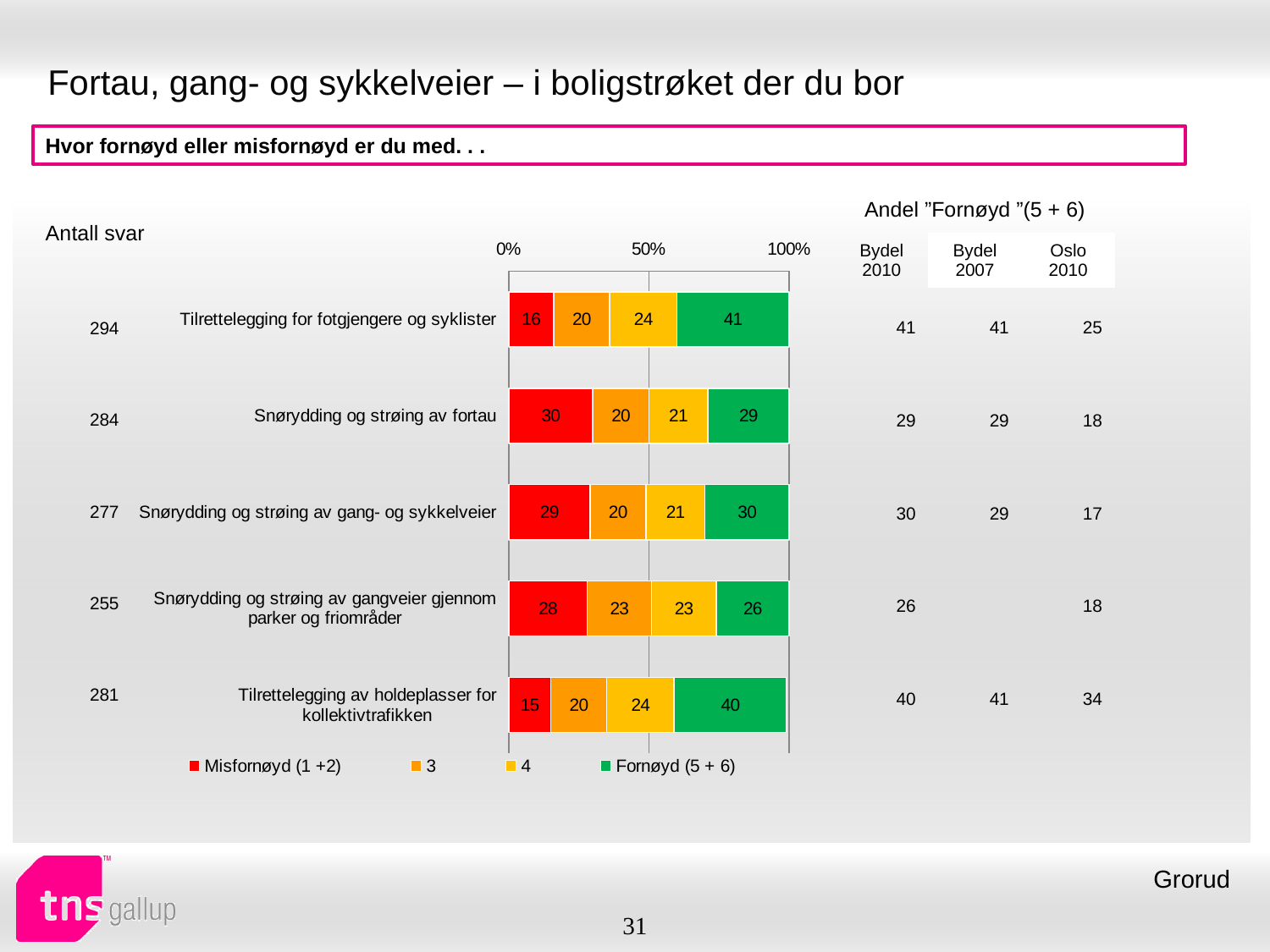
Which category has the highest "Fornøyd (5 + 6)" value? Tilrettelegging for fotgjengere og syklister How many categories are shown in the chart? 5 What kind of chart is shown on the slide? Stacked bar chart What colour represents the "Fornøyd (5 + 6)" series in the chart? Green Which is larger: the "Misfornøyd (1 +2)" value for "Snørydding og strøing av fortau" or for "Tilrettelegging av holdeplasser for kollektivtrafikken"? Snørydding og strøing av fortau What is the value of the "3" segment for "Snørydding og strøing av gangveier gjennom parker og friområder"? 23 What is the difference between the "Fornøyd (5 + 6)" values for "Tilrettelegging for fotgjengere og syklister" and "Snørydding og strøing av gangveier gjennom parker og friområder"? 15 What is the total of the stacked bar for "Snørydding og strøing av fortau"? 100 How many series does the legend list? 4 What is the value of the "Fornøyd (5 + 6)" segment for "Tilrettelegging for fotgjengere og syklister"? 41 Which category has the lowest "Misfornøyd (1 +2)" value? Tilrettelegging av holdeplasser for kollektivtrafikken What is the value of the "Misfornøyd (1 +2)" segment for "Snørydding og strøing av fortau"? 30